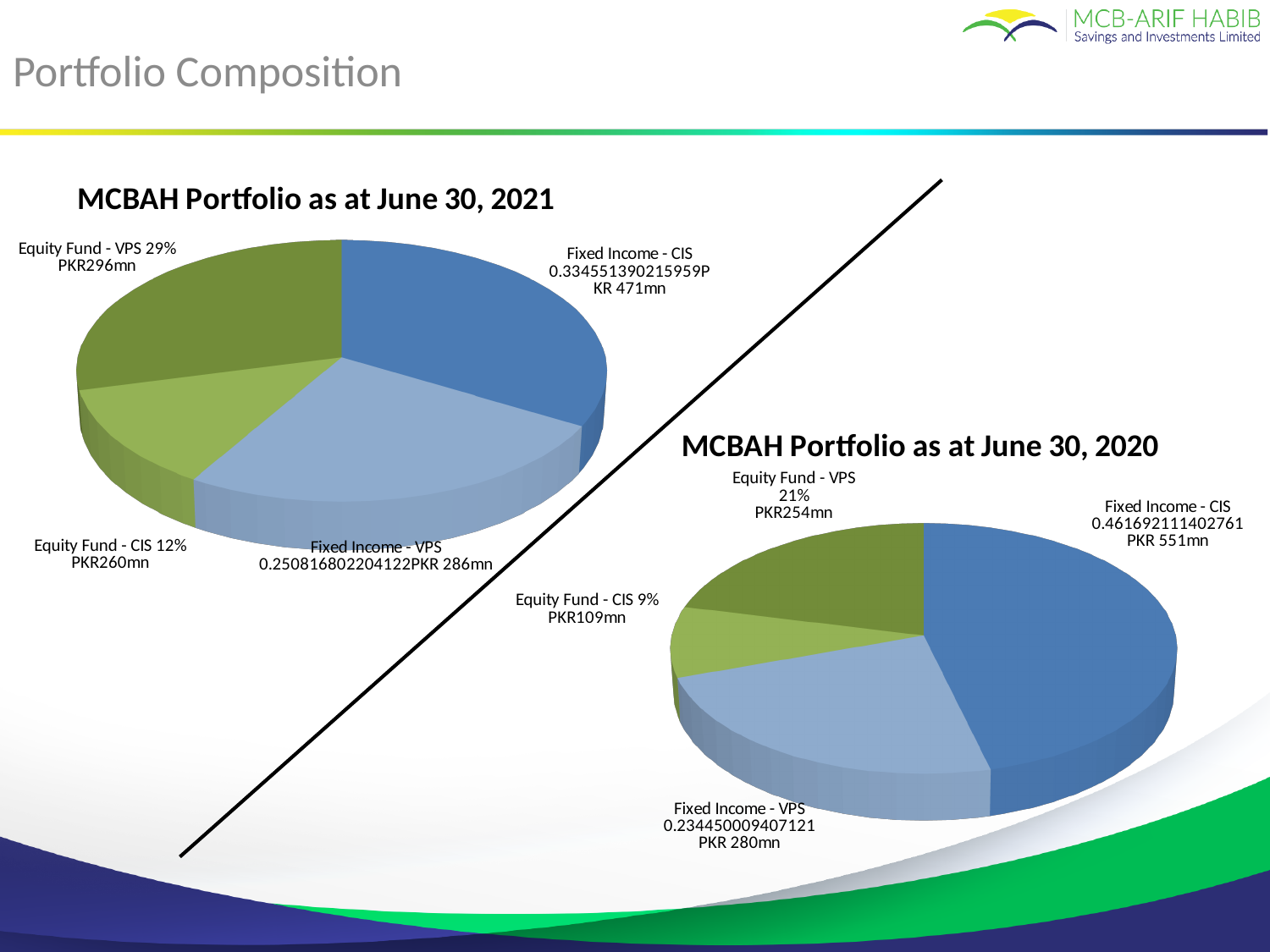
In the 'MCBAH Portfolio as at June 30, 2021' chart, what is the difference in PKR mn between Fixed Income - CIS and Fixed Income - VPS? PKR 185mn What kind of chart is the 'MCBAH Portfolio as at June 30, 2021' chart? Pie chart In the 'MCBAH Portfolio as at June 30, 2021' chart, what share of the pie does Equity Fund - VPS represent? 29% In the 'MCBAH Portfolio as at June 30, 2020' chart, what is the value for Equity Fund - CIS? PKR109mn In the 'MCBAH Portfolio as at June 30, 2021' chart, which category has the largest slice? Fixed Income - CIS In the 'MCBAH Portfolio as at June 30, 2020' chart, which is larger, Fixed Income - CIS or Fixed Income - VPS? Fixed Income - CIS In the 'MCBAH Portfolio as at June 30, 2020' chart, which category has the smallest slice? Equity Fund - CIS In the 'MCBAH Portfolio as at June 30, 2020' chart, what is the value for Fixed Income - VPS? PKR 280mn In the 'MCBAH Portfolio as at June 30, 2021' chart, what is the value for Equity Fund - VPS? PKR296mn In the 'MCBAH Portfolio as at June 30, 2021' chart, what is the value for Fixed Income - CIS? PKR 471mn How many categories are shown in the 'MCBAH Portfolio as at June 30, 2020' chart? 4 In the 'MCBAH Portfolio as at June 30, 2020' chart, what share of the pie does Equity Fund - VPS represent? 21%